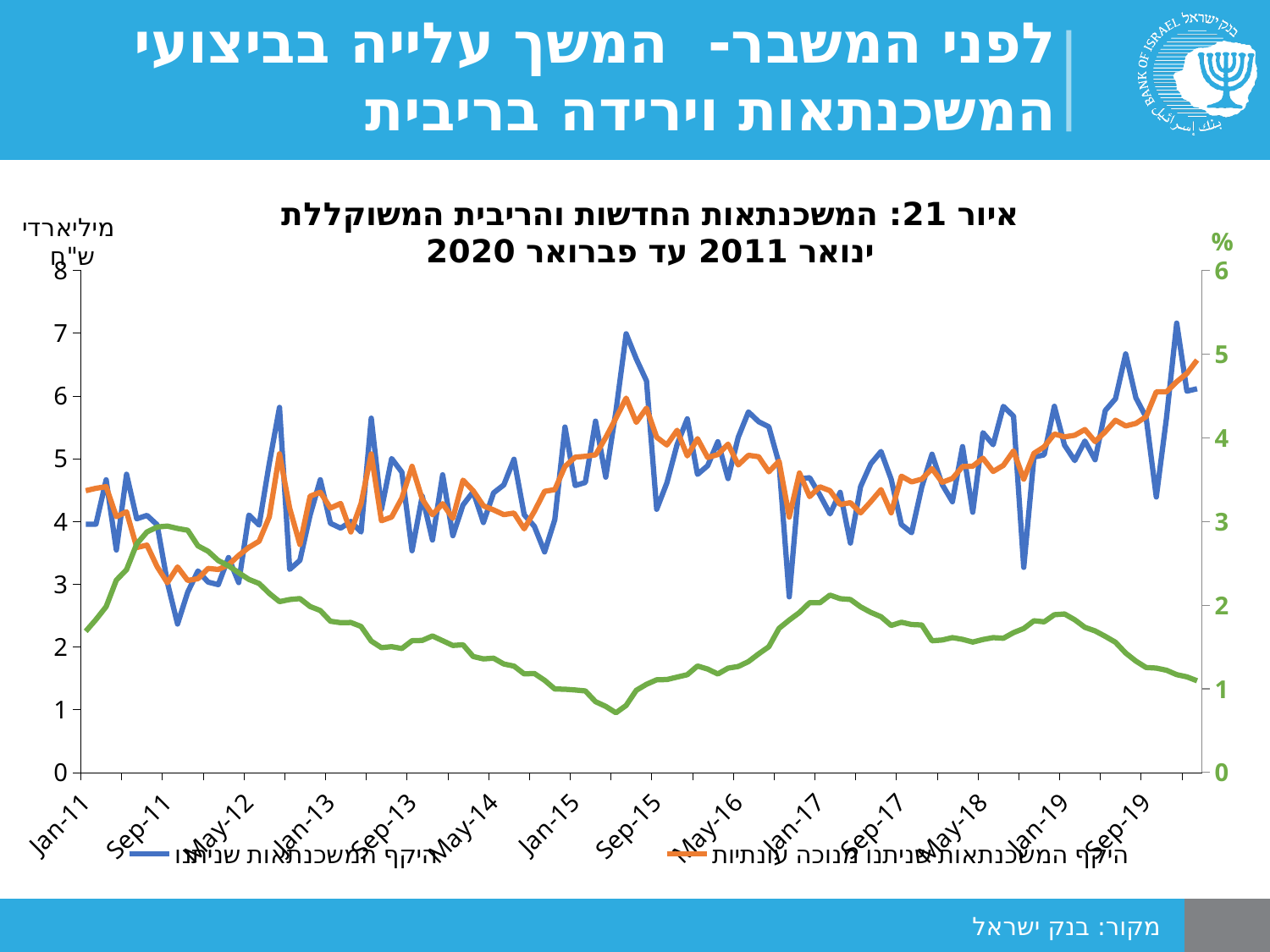
What kind of chart is shown on the slide? line chart What is the highest tick value on the right vertical axis? 6 Is the orange line higher at the end of the period (early 2020) or at Jan-11? at the end of the period Does the green line (right axis, %) rise or fall overall from Jan-11 to the end of the period? fall How many lines are plotted on the chart? 3 Does the orange line (seasonally adjusted mortgages) rise or fall overall from Jan-11 to the end of the period? rise What unit is shown on the left vertical axis? מיליארדי ש"ח What is the highest tick value on the left vertical axis? 8 Is the value of the green line at the end of the period (early 2020) greater or less than 2 on the right axis? less Is the lowest point of the blue line (around Sep-11) greater or less than 3 on the left axis? less What is the title of the chart? איור 21: המשכנתאות החדשות והריבית המשוקללת ינואר 2011 עד פברואר 2020 Is the value of the orange line at Jan-11 greater or less than 4 on the left axis? greater